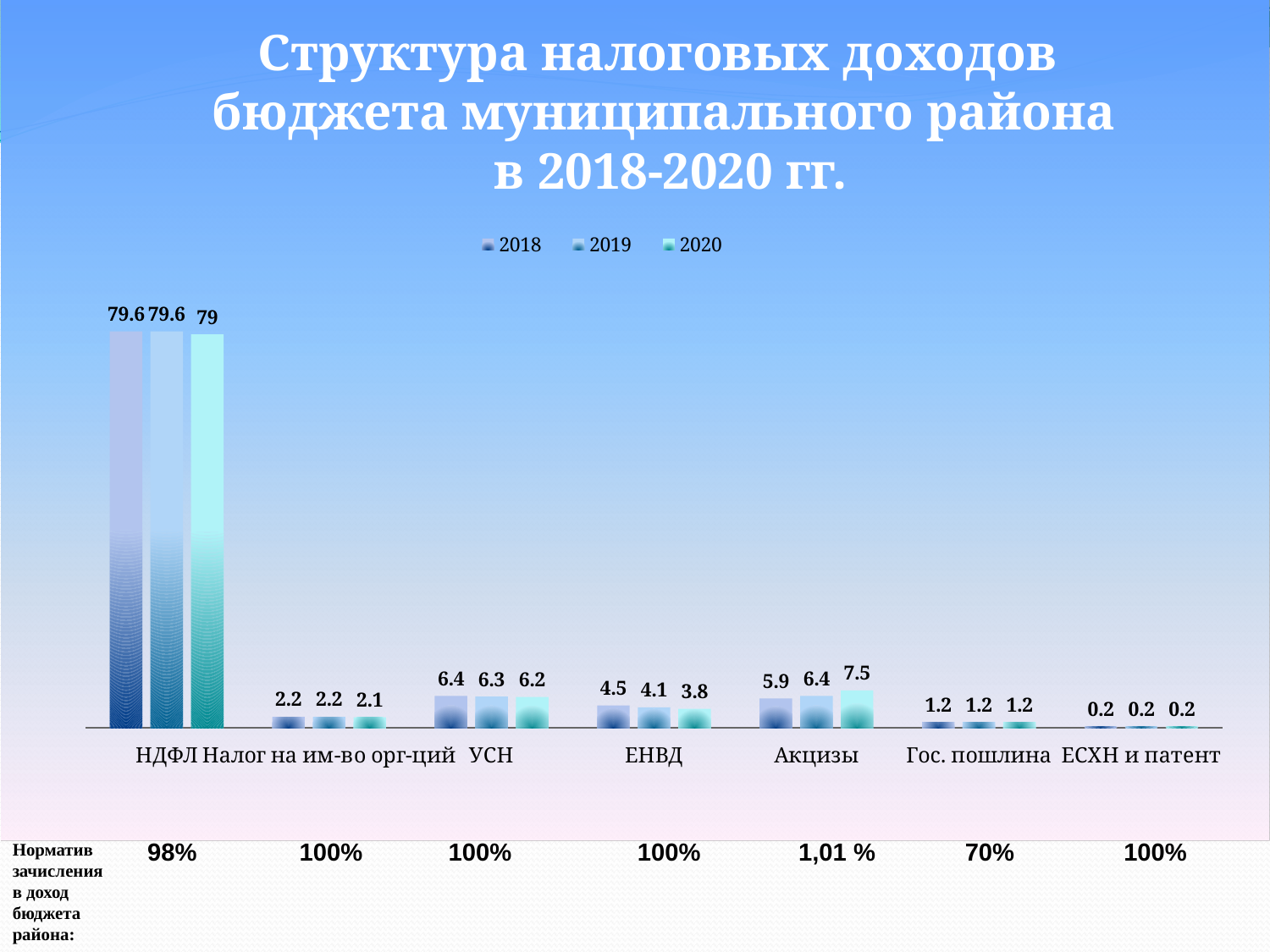
What is the value for Акцизы in 2019? 6.4 How many series does the legend list? 3 Which category has the highest value in 2018? НДФЛ Which is larger in 2020: УСН or Акцизы? Акцизы What kind of chart is shown on the slide? bar chart Do the values for Акцизы rise or fall from 2018 to 2020? rise What is the difference between the 2018 and 2020 values for ЕНВД? 0.7 How many categories are shown on the x axis? 7 What is the value for ЕНВД in 2018? 4.5 What is the value for НДФЛ in 2020? 79 Which category has the lowest value in 2020? ЕСХН и патент What is the difference between the 2020 and 2018 values for Акцизы? 1.6